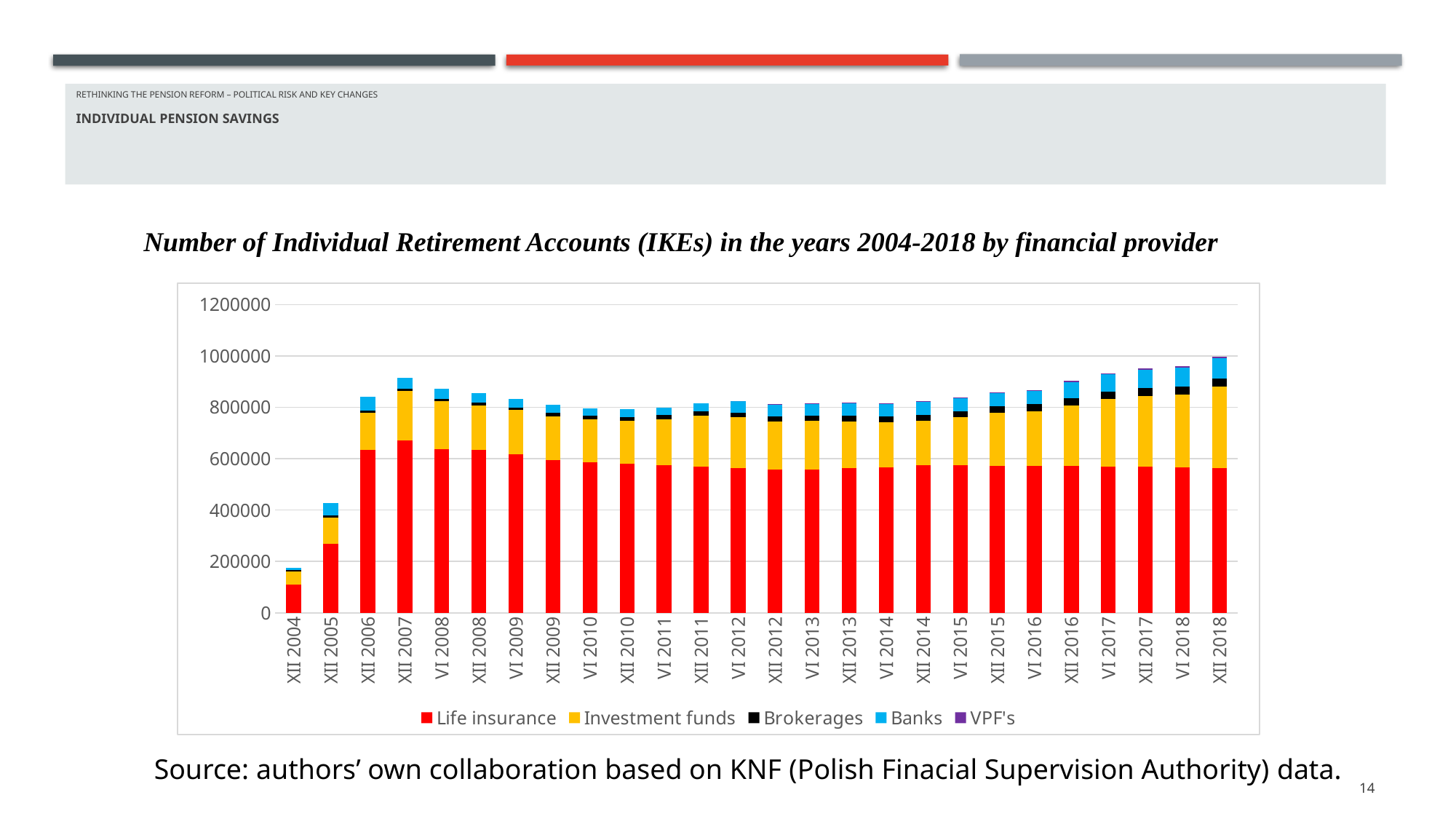
Do the total numbers of IKEs rise or fall from XII 2004 to XII 2007? Rise Is the total number of IKEs in XII 2004 greater or less than 200000? less Which period has the lowest total number of IKEs? XII 2004 Which period has the highest total number of IKEs? XII 2018 What kind of chart is shown on the slide? Stacked bar chart How many series does the legend list? 5 Is the total number of IKEs in XII 2007 greater or less than 800000? greater How many time periods (bars) are shown along the x axis? 26 Which period has a larger total number of IKEs, XII 2007 or XII 2008? XII 2007 Is the total number of IKEs in XII 2005 greater or less than 400000? greater Which colour represents Life insurance in the legend? Red In which period is the Life insurance segment the largest? XII 2007